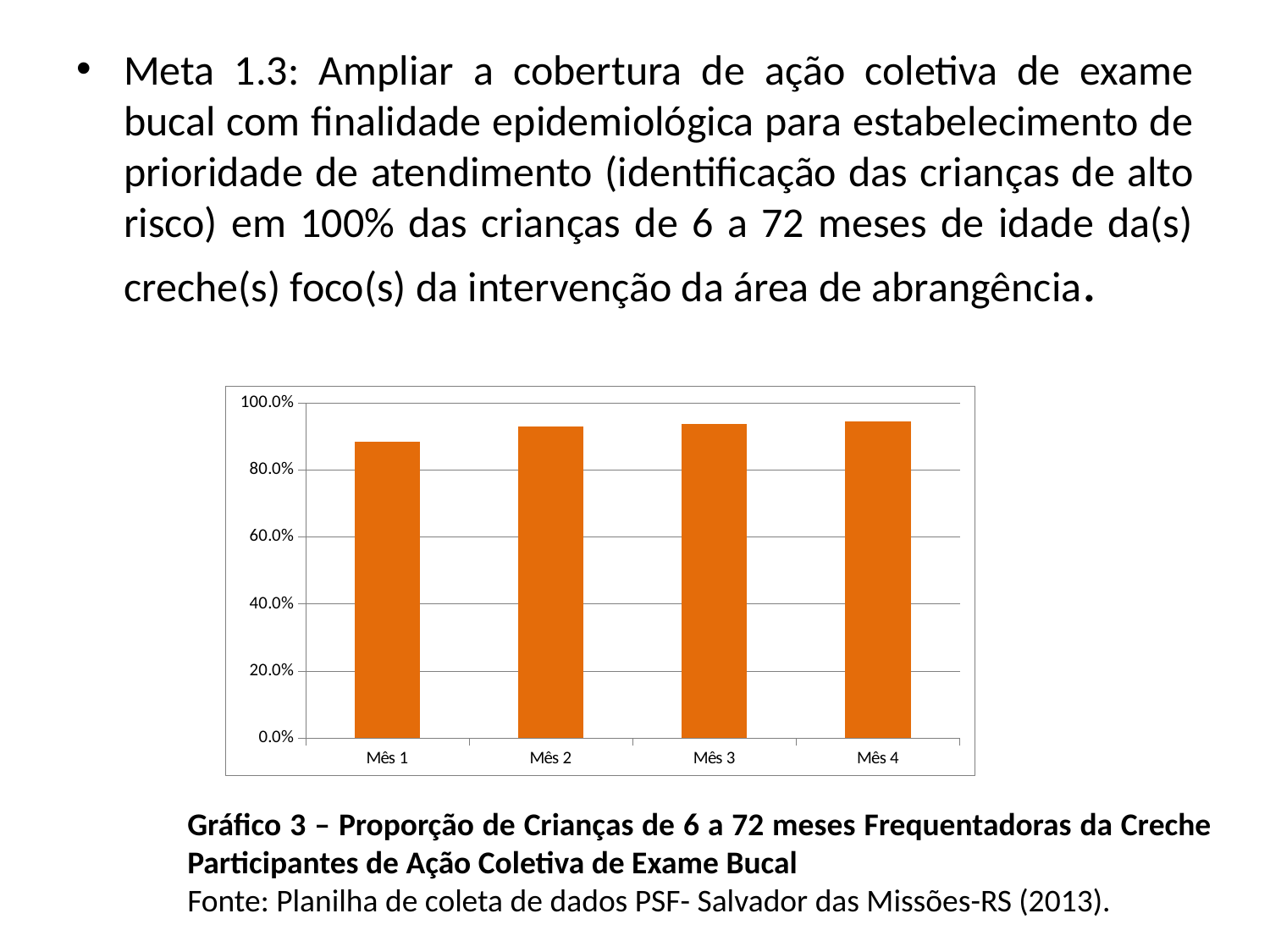
Which is larger, the value for Mês 1 or the value for Mês 2? Mês 2 Is the value for Mês 2 greater or less than 80.0%? greater Is the value for Mês 1 greater or less than 80.0%? greater How many categories (months) are plotted on the chart? 4 Which is larger, the value for Mês 1 or the value for Mês 4? Mês 4 What kind of chart is shown on the slide? bar chart Is the value for Mês 4 greater or less than 100.0%? less What is the label of the first category on the horizontal axis? Mês 1 Do the values rise or fall from Mês 1 to Mês 4? rise What is the highest tick value shown on the vertical axis? 100.0% Which month has the lowest value on the chart? Mês 1